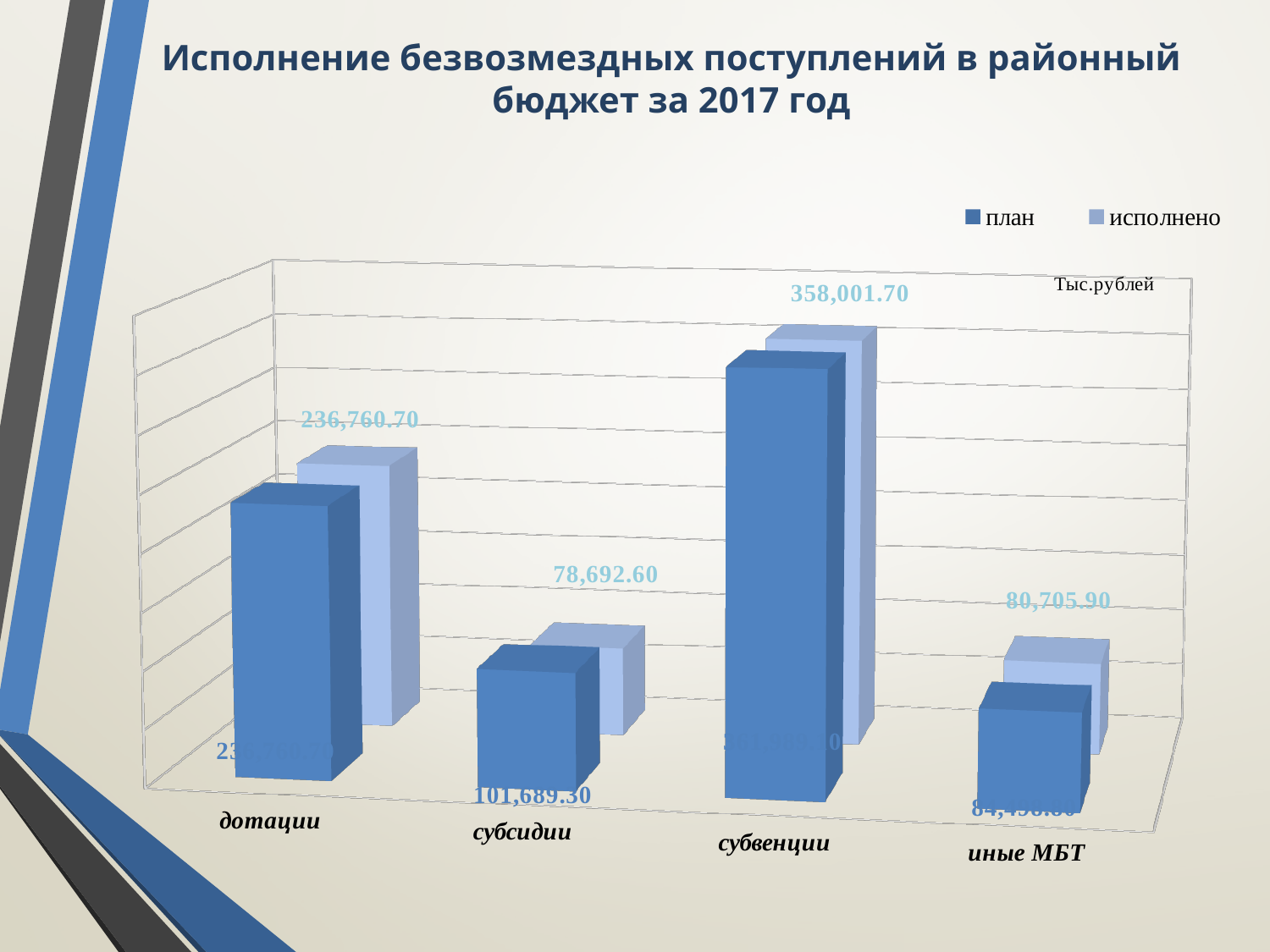
What is the исполнено value for субвенции? 358,001.70 Which category has the lowest исполнено value? субсидии What kind of chart is shown on the slide? bar chart How many series does the legend list? 2 What is the исполнено value for субсидии? 78,692.60 What is the исполнено value for дотации? 236,760.70 What is the план value for субсидии? 101,689.30 What is the difference between the план and исполнено values for субсидии? 22,996.70 For субсидии, which is larger: план or исполнено? план How many categories are shown on the x axis? 4 Which category has the highest исполнено value? субвенции What is the исполнено value for иные МБТ? 80,705.90